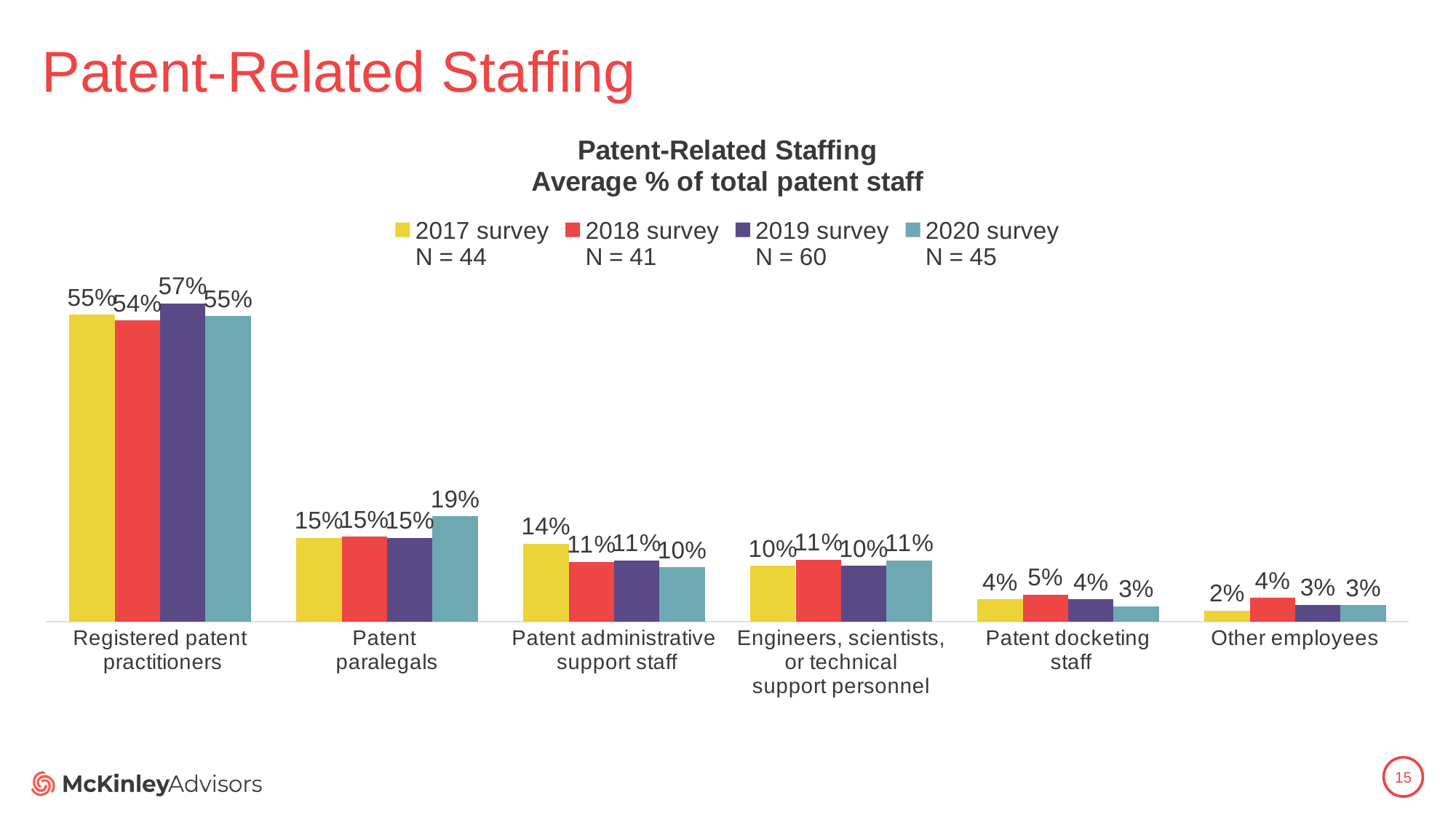
What is the 2019 survey value for Registered patent practitioners? 57% Which category has the lowest value in the 2017 survey? Other employees What is the 2017 survey value for Other employees? 2% How many series does the legend list? 4 Which category has the highest value in the 2020 survey? Registered patent practitioners What is the difference between the 2020 survey and 2017 survey values for Patent paralegals? 4% What kind of chart is shown? Bar chart Which is larger for Patent administrative support staff: the 2017 survey value or the 2020 survey value? 2017 survey How many categories are shown on the x axis? 6 What is the sample size (N) for the 2019 survey shown in the legend? N = 60 What is the 2017 survey value for Patent administrative support staff? 14% What is the 2020 survey value for Patent paralegals? 19%